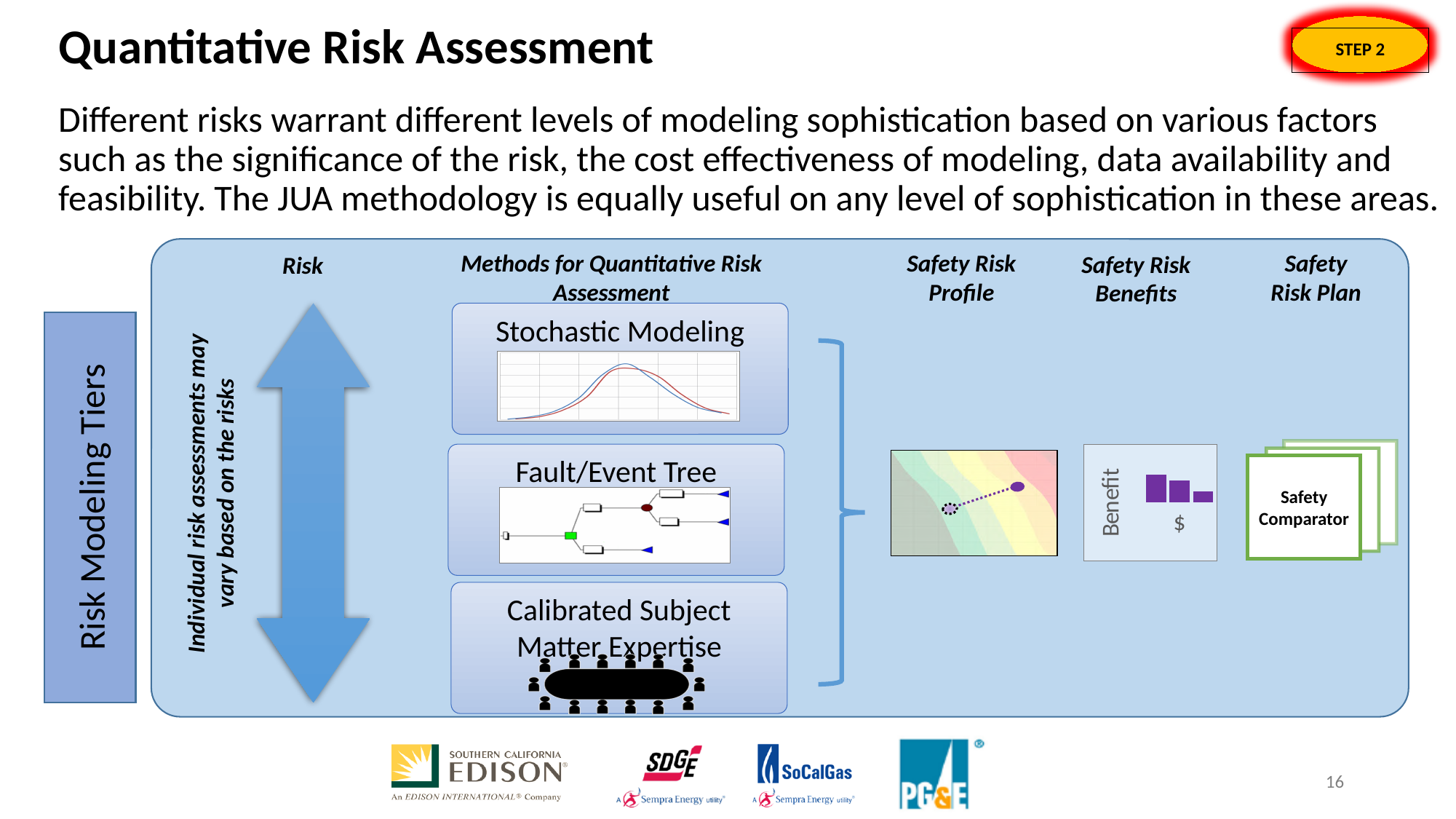
How many bars are in the Safety Risk Benefits chart? 3 In the Safety Risk Benefits chart, do the bars rise or fall from left to right? fall What colour are the bars in the Safety Risk Benefits chart? purple What is the vertical axis label of the Safety Risk Benefits chart? Benefit In the Safety Risk Benefits chart, which bar is the shortest? the rightmost bar In the Safety Risk Benefits chart, which bar is the tallest? the leftmost bar What kind of chart is shown under the Safety Risk Benefits heading? bar chart How many curves are plotted in the Stochastic Modeling chart? 2 What kind of chart is shown under the Stochastic Modeling box? line chart What colours are the two curves in the Stochastic Modeling chart? blue and red